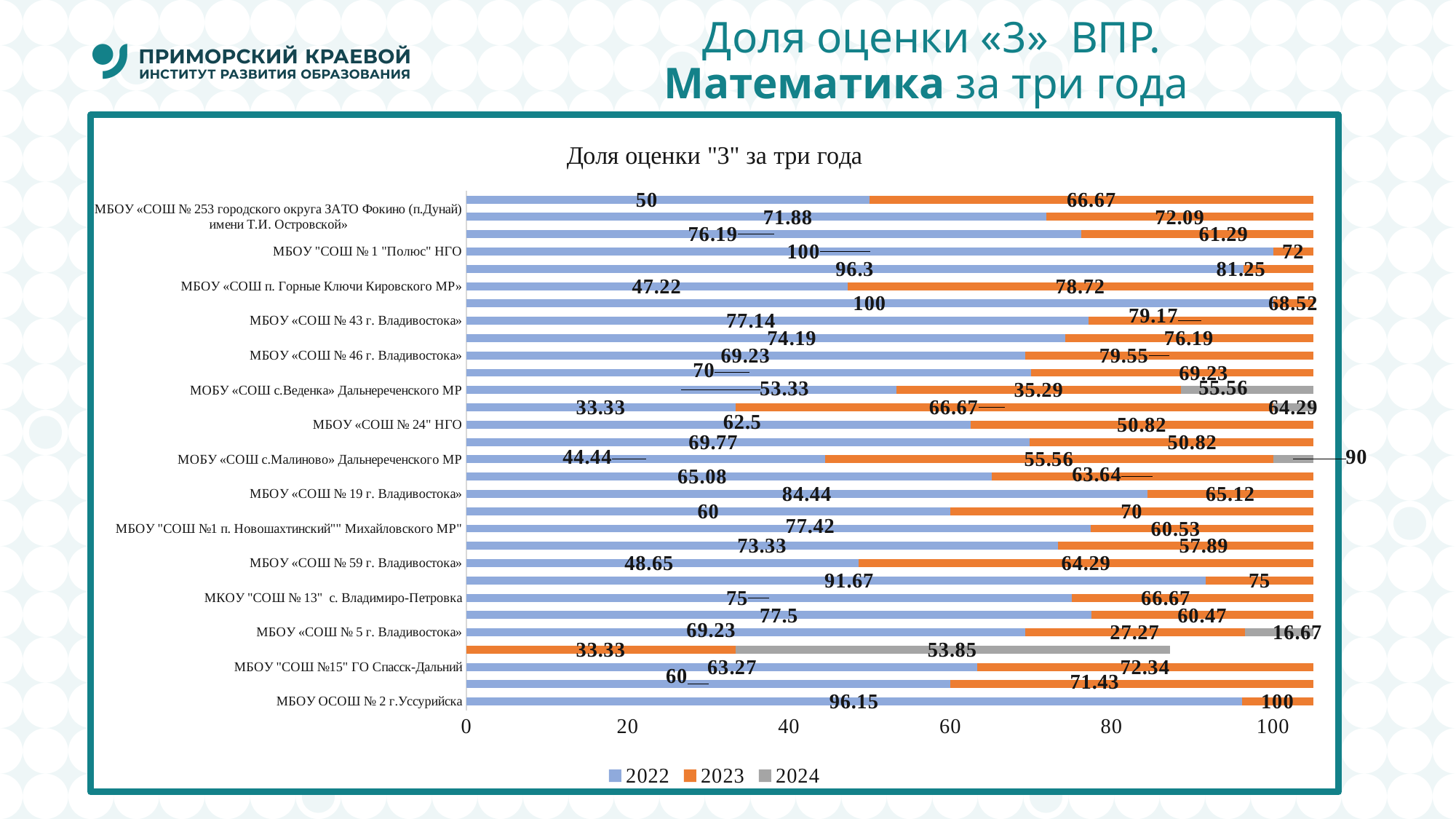
How many series does the legend list? 3 What is the 2022 value for МБОУ "СОШ № 1 "Полюс" НГО? 100 What kind of chart is shown on the slide? bar chart What is the 2024 value for МОБУ «СОШ с.Малиново» Дальнереченского МР? 90 What is the difference between the 2022 and 2023 values for МБОУ «СОШ № 59 г. Владивостока»? 15.64 Which is larger for МБОУ «СОШ № 19 г. Владивостока»: the 2022 value or the 2023 value? 2022 What is the chart's title? Доля оценки "3" за три года What is the 2023 value for МБОУ ОСОШ № 2 г.Уссурийска? 100 Which years are listed in the legend? 2022, 2023, 2024 What is the 2024 value for МБОУ «СОШ № 5 г. Владивостока»? 16.67 What is the 2023 value for МБОУ «СОШ п. Горные Ключи Кировского МР»? 78.72 What is the 2022 value for МБОУ ОСОШ № 2 г.Уссурийска? 96.15